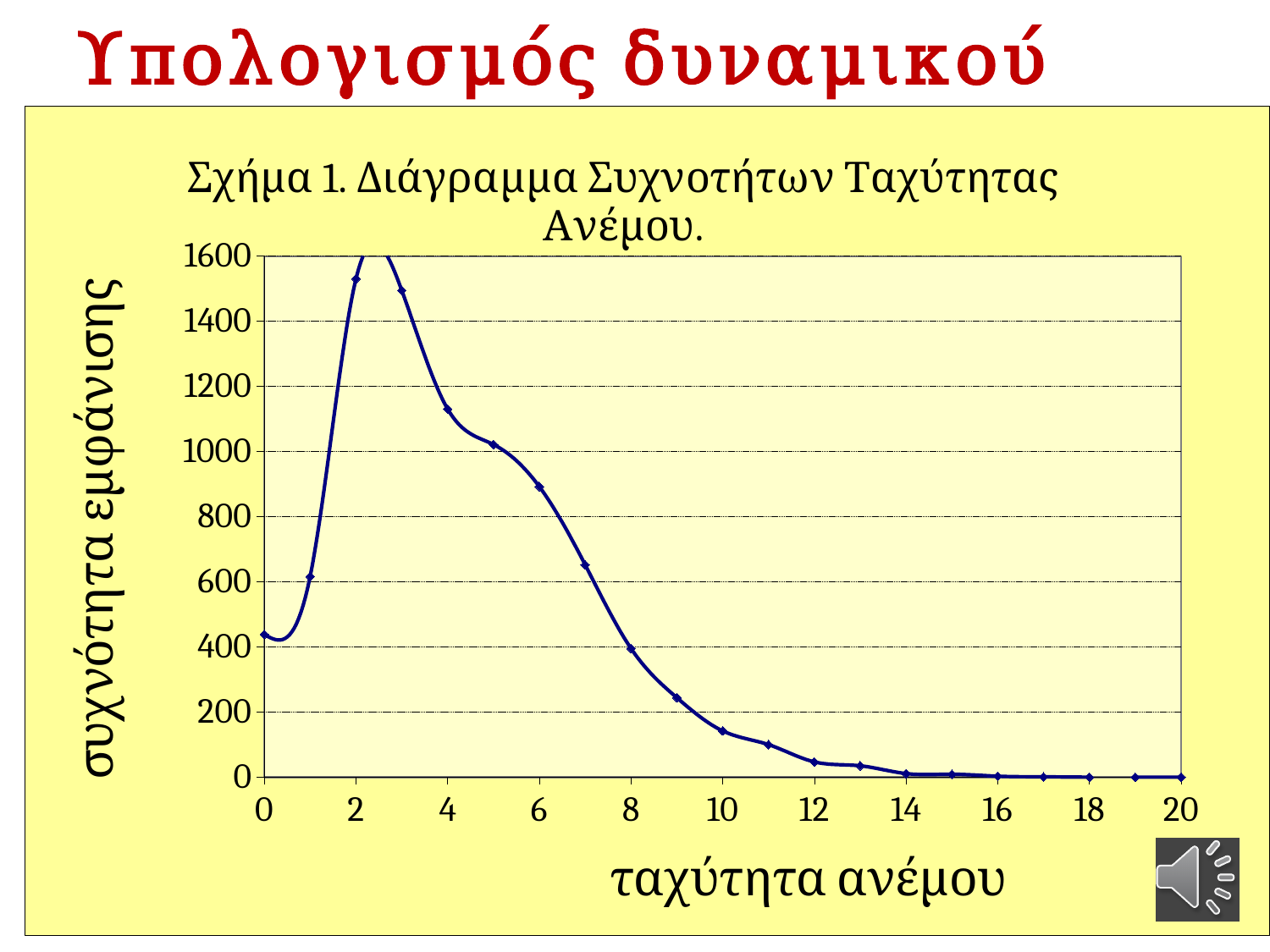
Is the value at wind speed 4 greater or less than 1000? greater Is the value at wind speed 6 greater or less than 800? greater Is the value at wind speed 12 greater or less than 200? less Which is larger, the value at wind speed 2 or the value at wind speed 8? wind speed 2 How many data points are plotted on the line (wind speeds 0 through 20)? 21 What kind of chart is shown on the slide? line chart What is the label of the x axis? ταχύτητα ανέμου Do the values rise or fall along the x axis from wind speed 4 to wind speed 20? fall What is the title of the chart? Σχήμα 1. Διάγραμμα Συχνοτήτων Ταχύτητας Ανέμου.